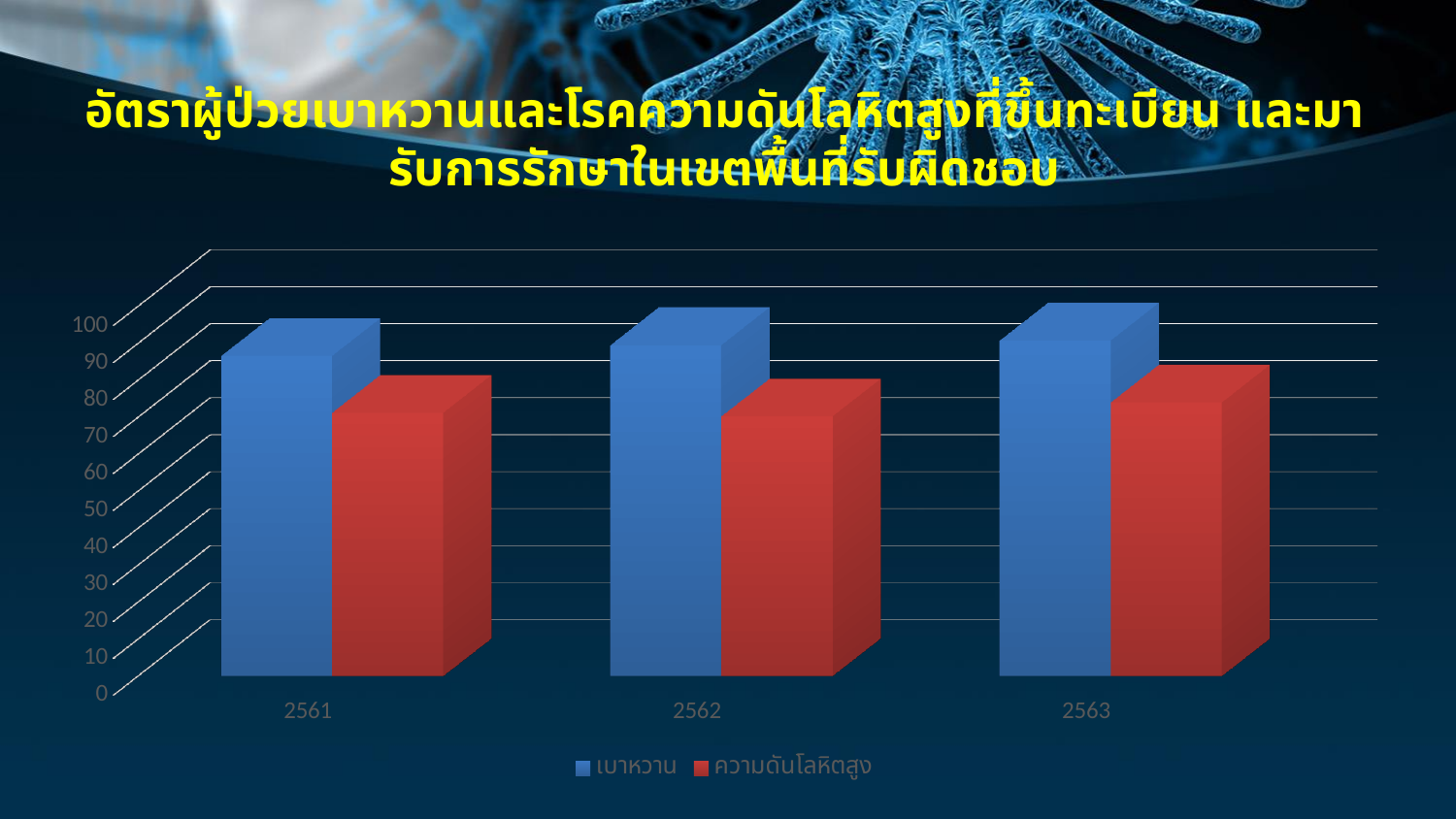
In 2561, which is larger: เบาหวาน or ความดันโลหิตสูง? เบาหวาน Is the value for ความดันโลหิตสูง in 2562 greater or less than 90? less Do the values for เบาหวาน rise or fall from 2561 to 2563? rise Is the value for เบาหวาน in 2561 greater or less than 80? greater Which series is shown in blue? เบาหวาน Which series is shown in red? ความดันโลหิตสูง How many series does the legend list? 2 What kind of chart is shown on the slide? bar chart Is the value for เบาหวาน in 2562 greater or less than 70? greater In 2563, which is larger: เบาหวาน or ความดันโลหิตสูง? เบาหวาน How many years (categories) are shown on the x axis? 3